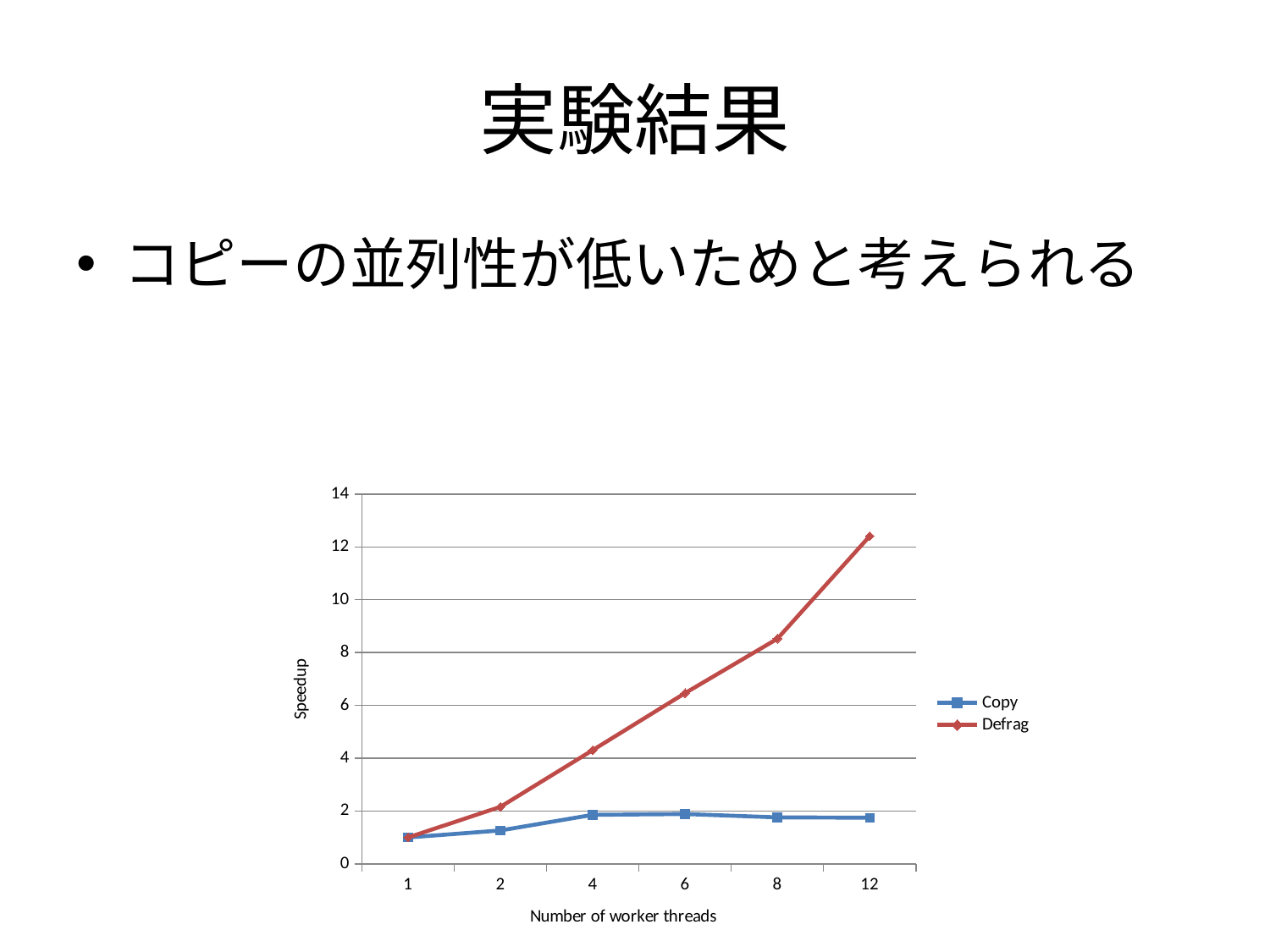
Is the Defrag speedup at 12 worker threads greater or less than 10? greater How many series does the chart legend list? 2 Which series has the higher speedup at 8 worker threads? Defrag How many worker-thread counts are plotted along the x axis? 6 What is the title of the x axis? Number of worker threads Is the Defrag speedup at 8 worker threads greater or less than 6? greater At which number of worker threads does the Defrag series reach its highest speedup? 12 What kind of chart is shown on the slide? line chart Does the Defrag speedup rise or fall as the number of worker threads increases? rises At 12 worker threads, which series has the higher speedup, Copy or Defrag? Defrag What is the title of the y axis? Speedup Is the Copy speedup at 12 worker threads greater or less than 4? less